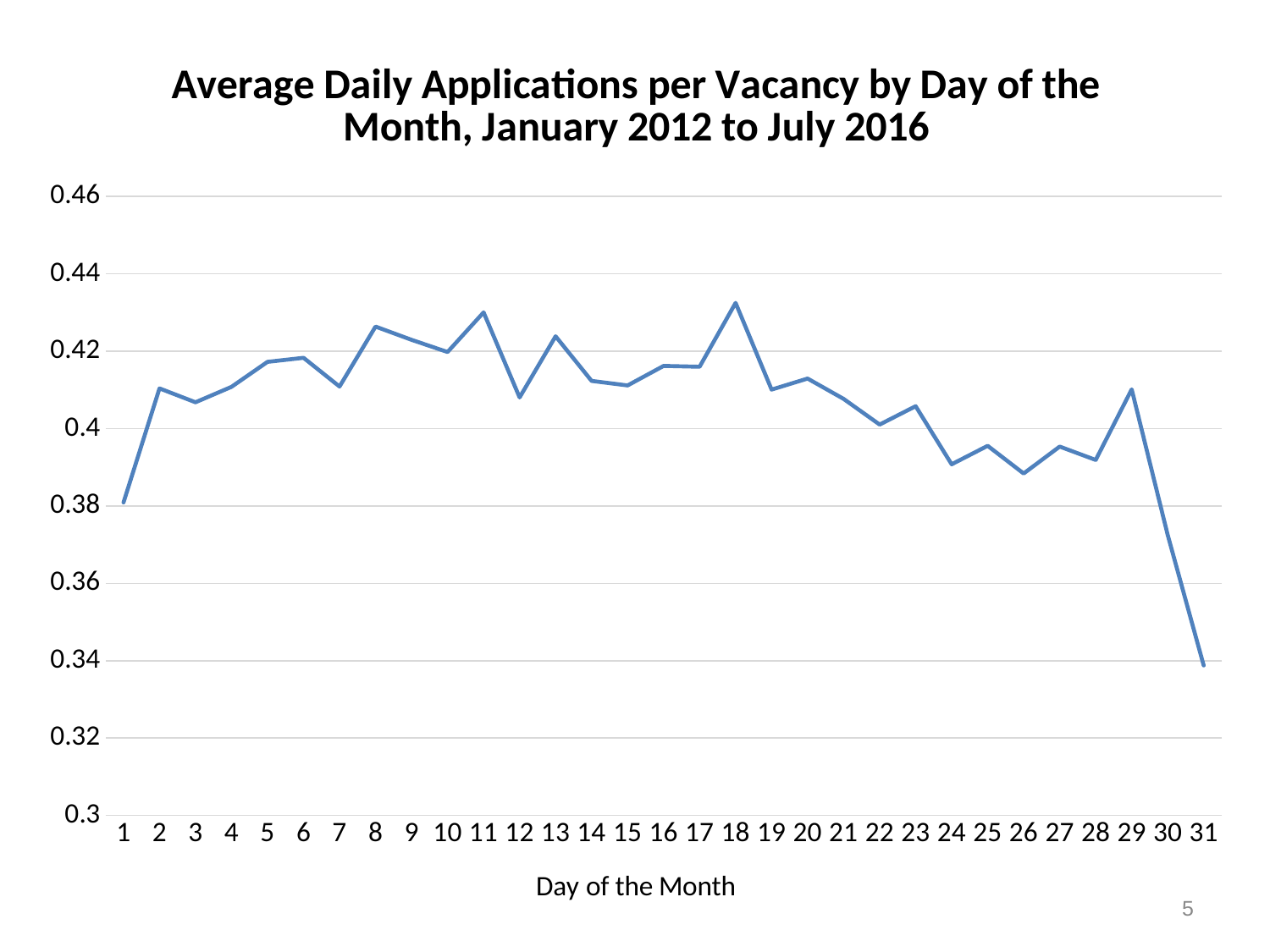
Is the value for day 31 greater or less than 0.36? less Which day of the month has the lowest average daily applications per vacancy? 31 Is the value for day 1 greater or less than 0.40? less Which has the larger value, day 12 or day 13? day 13 What kind of chart is shown on the slide? line chart Is the value for day 26 greater or less than 0.40? less Which has the larger value, day 1 or day 31? day 1 Do the values rise or fall from day 29 to day 31? fall How many days of the month are plotted on the x axis? 31 What is the title of the x axis? Day of the Month